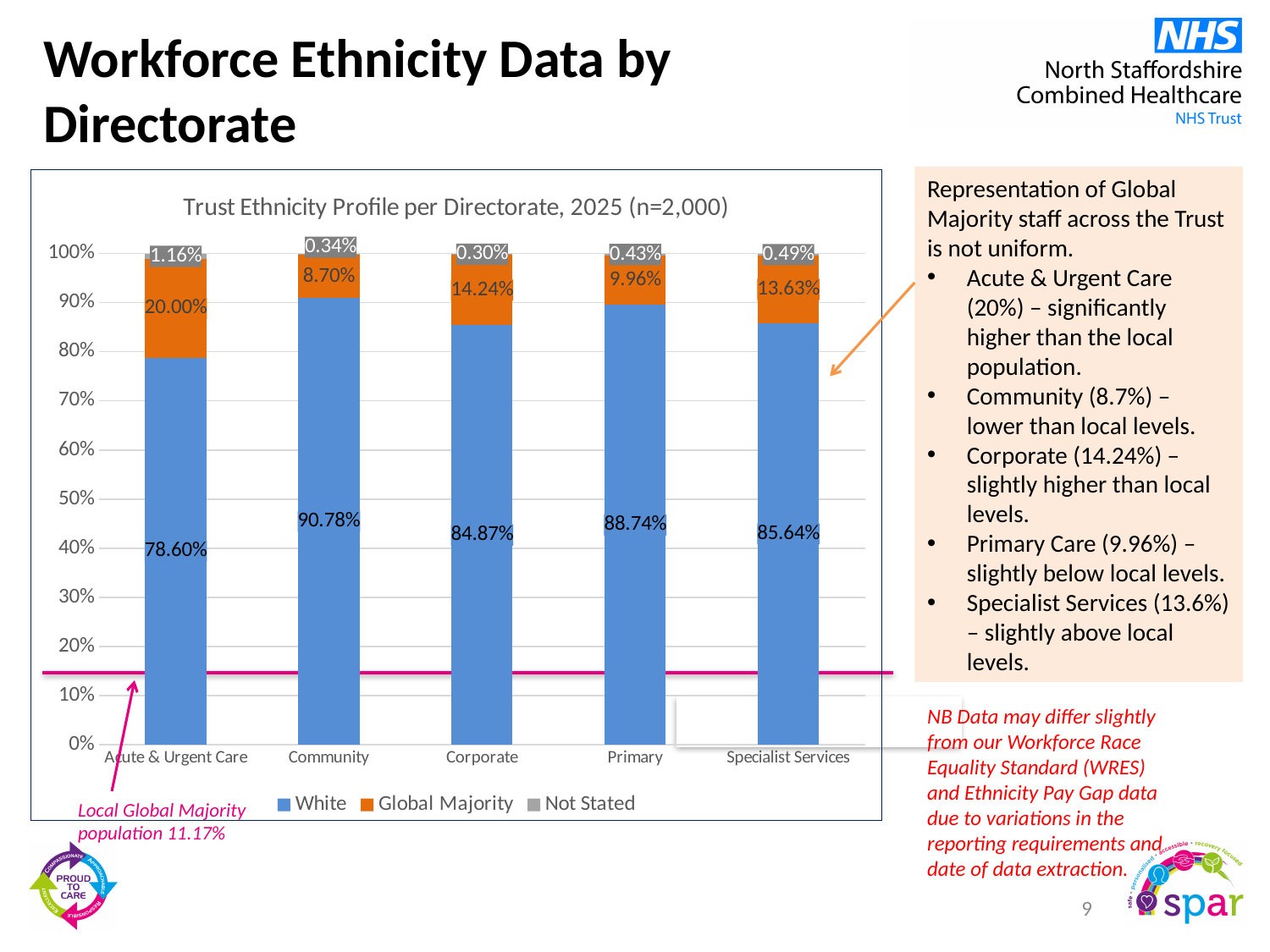
What is the Not Stated percentage for Corporate? 0.30% What is the Global Majority percentage for Specialist Services? 13.63% How many series does the legend list? 3 What kind of chart is shown? Stacked bar chart How many directorates are shown on the x axis? 5 What is the difference between the Global Majority percentages for Corporate and Primary? 4.28% What is the title of the chart? Trust Ethnicity Profile per Directorate, 2025 (n=2,000) Which directorate has the highest White percentage? Community Which directorate has the lowest Global Majority percentage? Community What is the White percentage for Community? 90.78% What is the Global Majority percentage for Acute & Urgent Care? 20.00% Which is larger, the White percentage for Primary or for Specialist Services? Primary